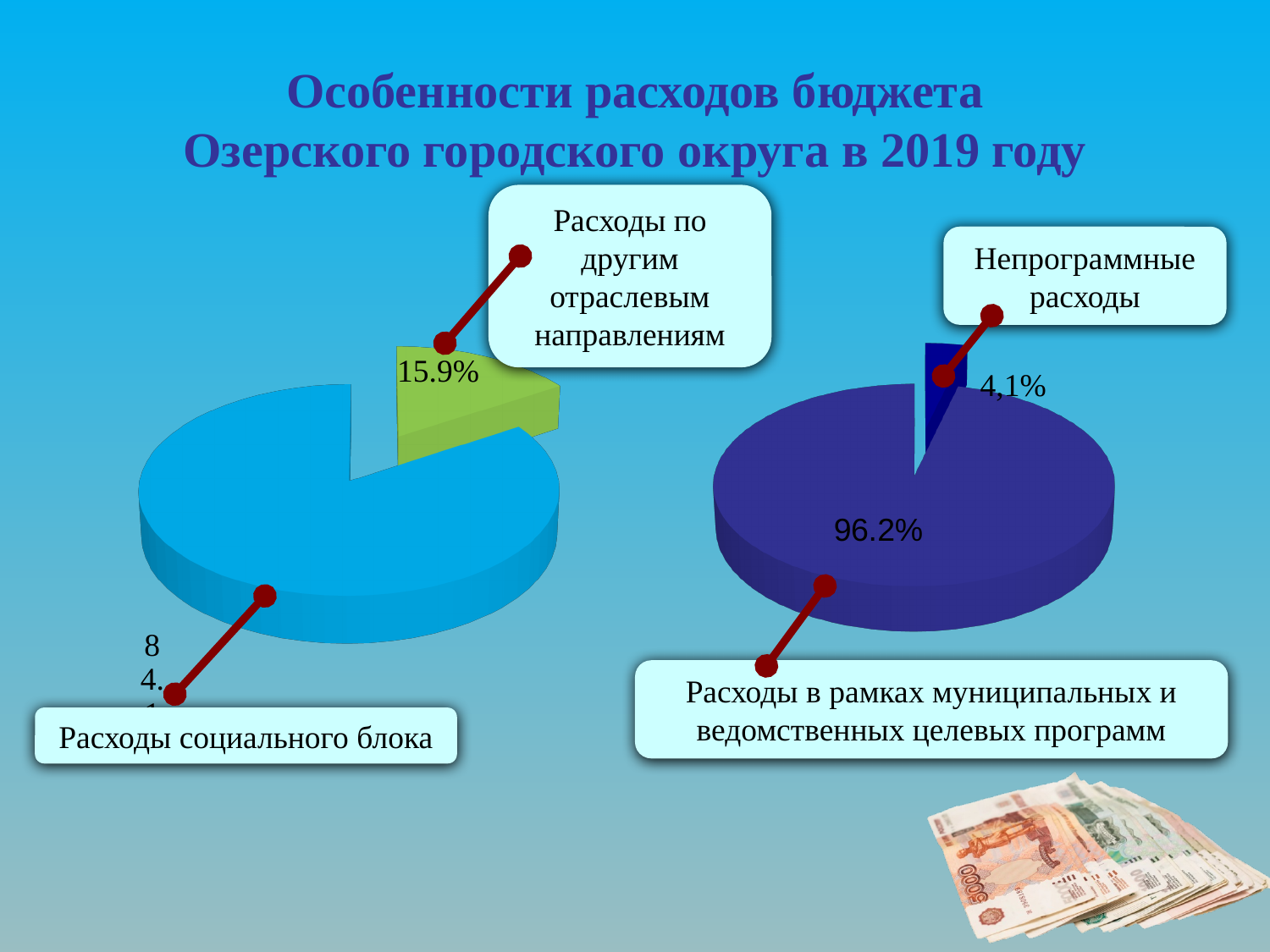
In the right pie chart, what share is shown for «Расходы в рамках муниципальных и ведомственных целевых программ»? 96.2% How many slices does the right pie chart have? 2 How many charts are shown on the slide? 2 What type of chart is the left chart on the slide? Pie chart In the right pie chart, which category has the smallest slice? Непрограммные расходы In the left pie chart, which category has the largest slice? Расходы социального блока In the right pie chart, by how many percentage points does the share of program expenses (96.2%) exceed «Непрограммные расходы» (4,1%)? 92.1 percentage points In the left pie chart, what colour is the slice for «Расходы по другим отраслевым направлениям»? Green In the right pie chart, what share is shown for «Непрограммные расходы»? 4,1% In the right pie chart, which is larger: «Непрограммные расходы» or «Расходы в рамках муниципальных и ведомственных целевых программ»? Расходы в рамках муниципальных и ведомственных целевых программ In the left pie chart, what share is shown for «Расходы по другим отраслевым направлениям»? 15.9% How many slices does the left pie chart have? 2